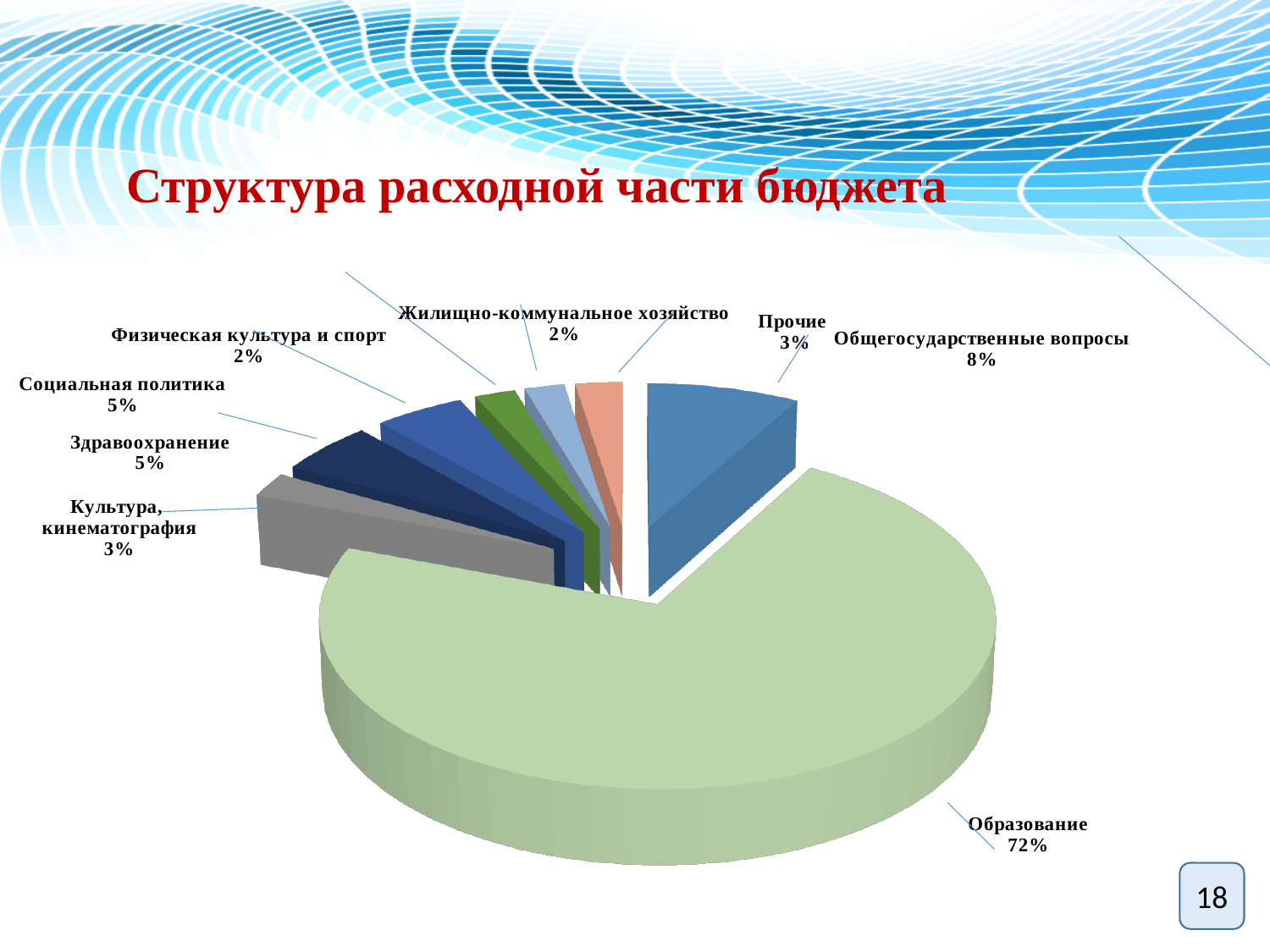
What share of the budget expenditure does Образование account for? 72% What is the title of the chart on the slide? Структура расходной части бюджета What percentage is shown for Жилищно-коммунальное хозяйство? 2% What percentage is shown for Общегосударственные вопросы? 8% How many categories are shown in the pie chart? 8 What percentage is shown for Здравоохранение? 5% What percentage is shown for Культура, кинематография? 3% What type of chart is shown on the slide? Pie chart Which is larger, the share for Социальная политика or the share for Прочие? Социальная политика Which category has the largest share of the pie? Образование What is the combined share of Здравоохранение and Социальная политика? 10% What is the difference in percentage points between Образование and Общегосударственные вопросы? 64